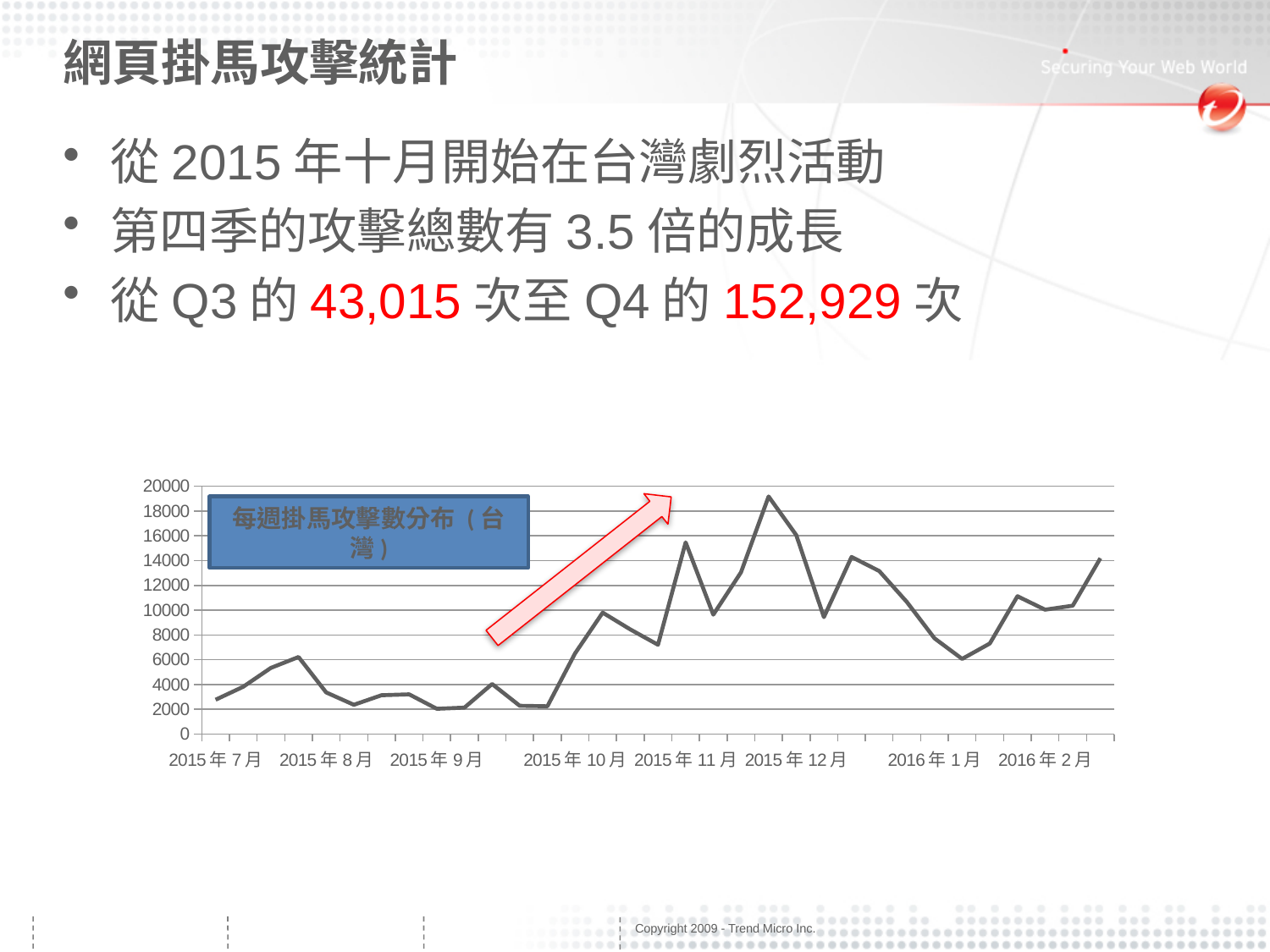
Which is higher, the peak in 2015年12月 or the peak in 2015年8月? 2015年12月 Is the value at the end of the line (2016年2月) greater or less than 12000? greater Is the value in 2015年8月 (the early peak) greater or less than 8000? less What is the highest value shown on the y axis of the chart? 20000 How many month labels are shown along the x axis of the chart? 8 Is the highest peak of the line greater or less than 18000? greater What is the title of the chart? 每週掛馬攻擊數分布（台灣） Does the line generally rise or fall between 2015年9月 and 2015年12月? rise What kind of chart is shown on the slide? line chart